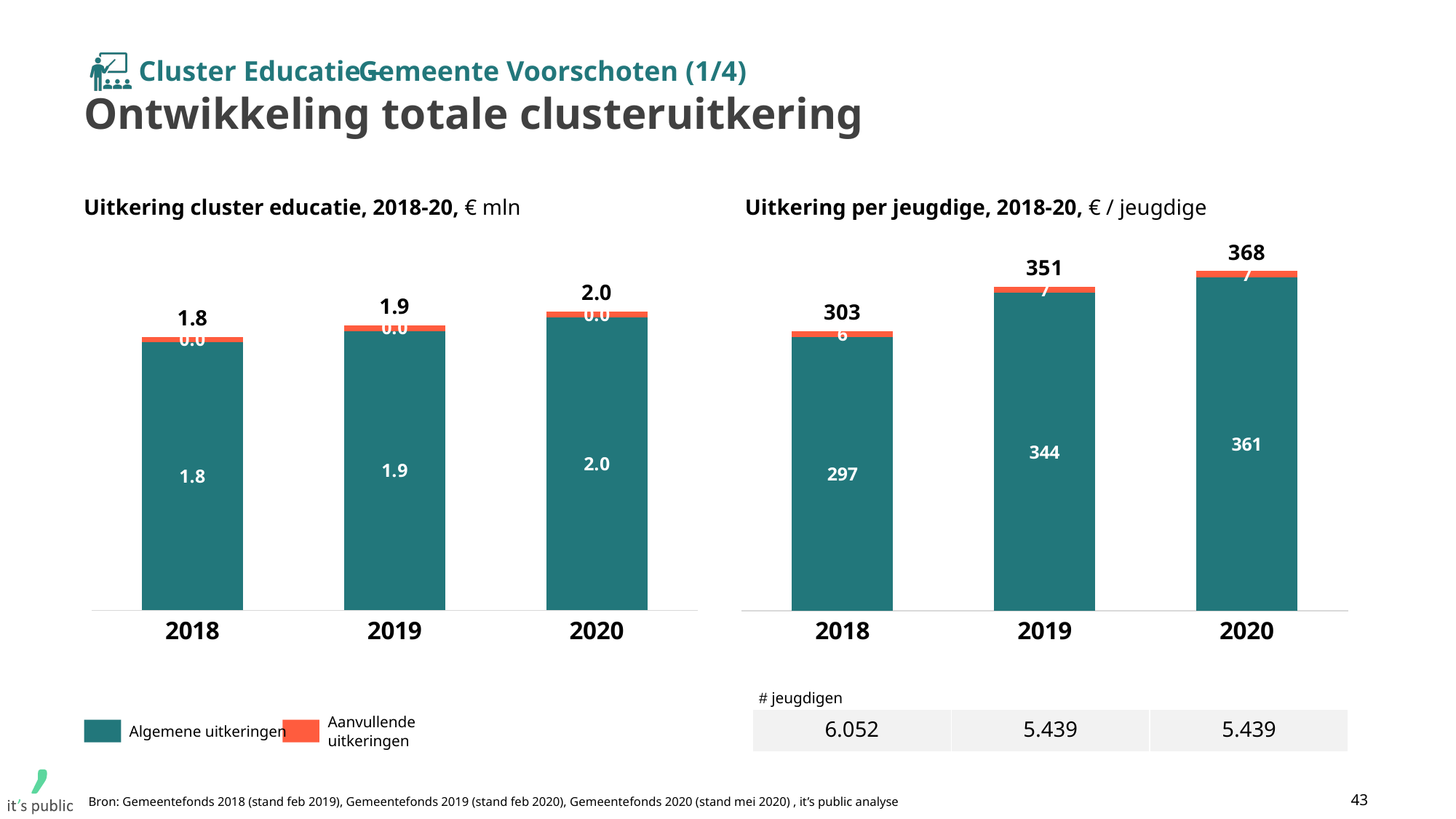
In the 'Uitkering per jeugdige, 2018-20' chart, what is the total value for 2019? 351 In the 'Uitkering per jeugdige, 2018-20' chart, what is the difference between the total for 2020 and the total for 2018? 65 In the 'Uitkering per jeugdige, 2018-20' chart, is the Algemene uitkeringen value larger in 2019 or in 2018? 2019 In the 'Uitkering cluster educatie, 2018-20' chart, which year has the lowest total? 2018 How many series does the legend list for the charts on this slide? 2 In the 'Uitkering per jeugdige, 2018-20' chart, what is the value of Algemene uitkeringen in 2020? 361 Do the totals in the 'Uitkering per jeugdige, 2018-20' chart rise or fall from 2018 to 2020? rise In the 'Uitkering per jeugdige, 2018-20' chart, what is the value of Aanvullende uitkeringen in 2018? 6 In the 'Uitkering cluster educatie, 2018-20' chart, what is the total value for 2020? 2.0 In the 'Uitkering per jeugdige, 2018-20' chart, which year has the highest total? 2020 In the 'Uitkering cluster educatie, 2018-20' chart, what is the value of Algemene uitkeringen in 2018? 1.8 How many years are shown on the x axis of the 'Uitkering cluster educatie, 2018-20' chart? 3